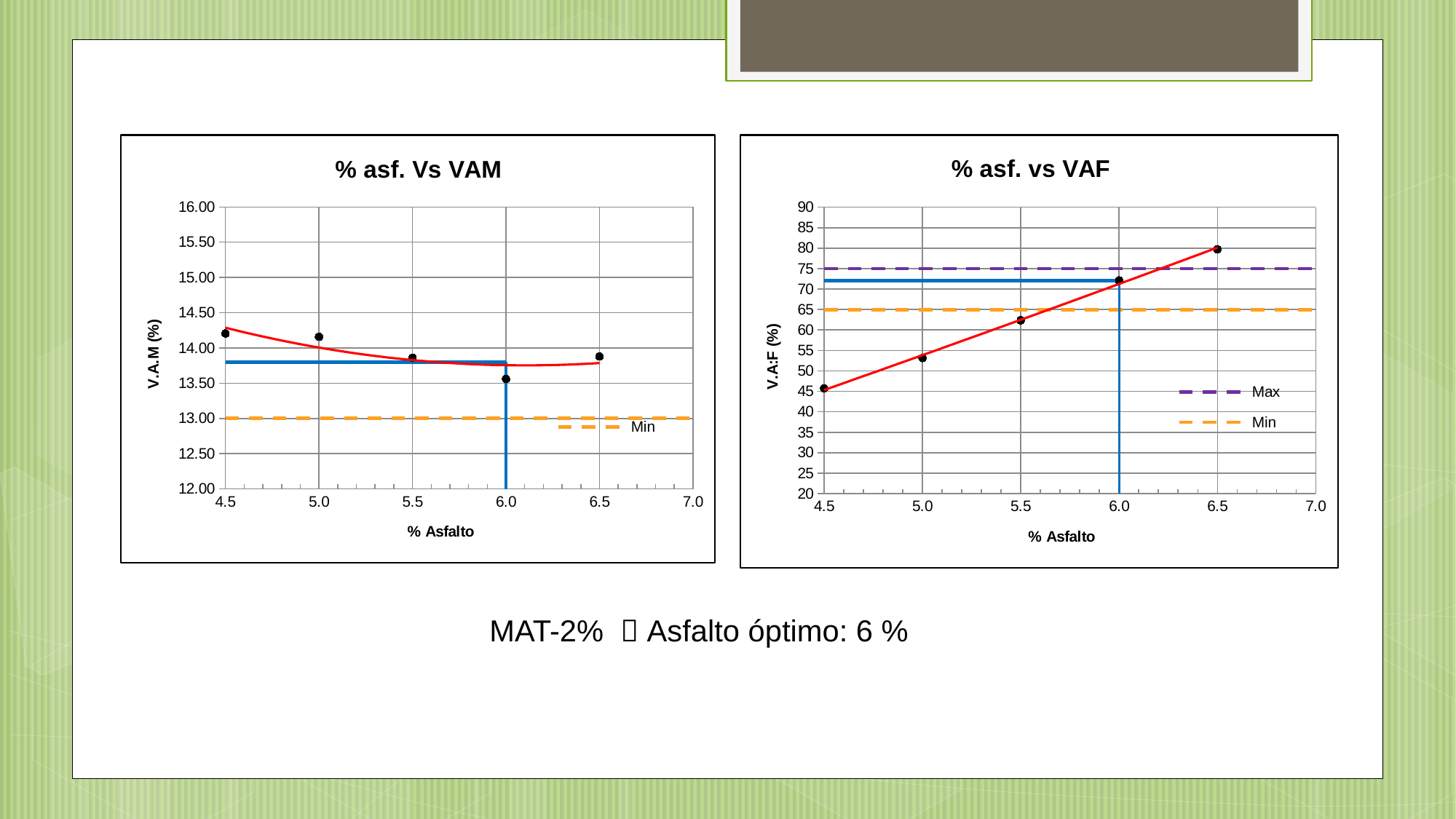
In the '% asf. vs VAF' chart, at which % Asfalto is the V.A.F value lowest? 4.5 In the '% asf. Vs VAM' chart, is the value at 6.0 % Asfalto greater or less than 14.00? less In the '% asf. vs VAF' chart, how many data points are plotted? 5 In the '% asf. vs VAF' chart, is the value at 4.5 % Asfalto greater or less than 50? less In the '% asf. vs VAF' chart, at what V.A.F value is the dashed 'Max' line drawn? 75 In the '% asf. vs VAF' chart, which entries does the legend list? Max and Min In the '% asf. vs VAF' chart, at which % Asfalto is the V.A.F value highest? 6.5 In the '% asf. vs VAF' chart, is the value at 6.5 % Asfalto greater or less than 75? greater In the '% asf. vs VAF' chart, do the plotted values rise or fall as % Asfalto increases? Rise In the '% asf. Vs VAM' chart, what kind of chart is it? Scatter chart with a fitted line In the '% asf. Vs VAM' chart, at which % Asfalto is the V.A.M value lowest? 6.0 In the '% asf. Vs VAM' chart, how many data points are plotted? 5